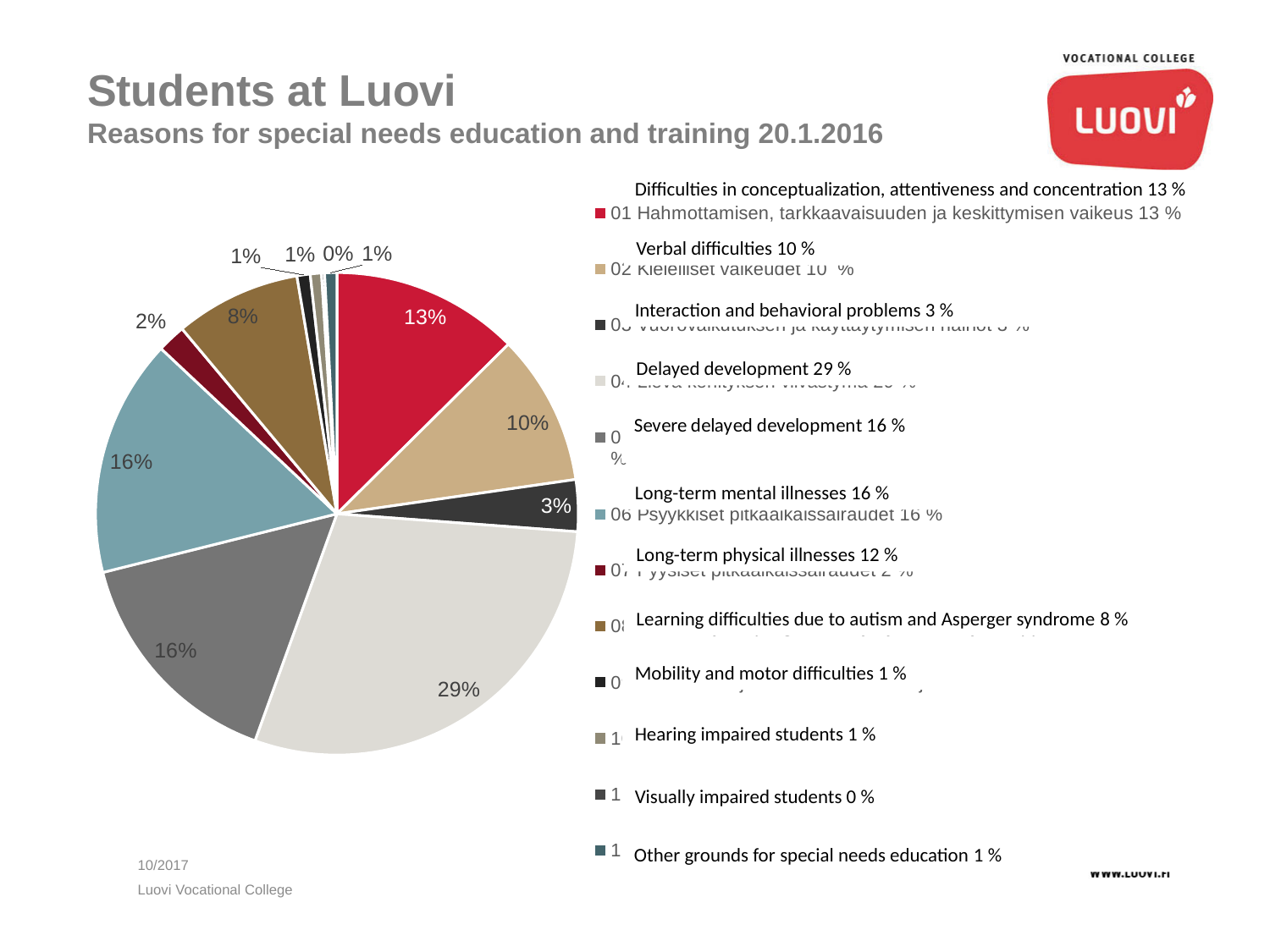
What kind of chart is shown on the slide? pie chart How many percentage points larger is the Delayed development slice than the Severe delayed development slice? 13 What is the subtitle of the slide above the chart? Reasons for special needs education and training 20.1.2016 What share of the pie is labelled for Delayed development? 29% What share of the pie is labelled for Interaction and behavioral problems? 3% What share of the pie is labelled for Verbal difficulties? 10% What share of the pie is labelled for Difficulties in conceptualization, attentiveness and concentration? 13% Which slice is larger: Verbal difficulties or Learning difficulties due to autism and Asperger syndrome? Verbal difficulties Which reason has the largest slice of the pie? Delayed development How many slices does the pie chart have? 12 Which reason has the smallest slice of the pie? Visually impaired students What share of the pie is labelled for Learning difficulties due to autism and Asperger syndrome? 8%